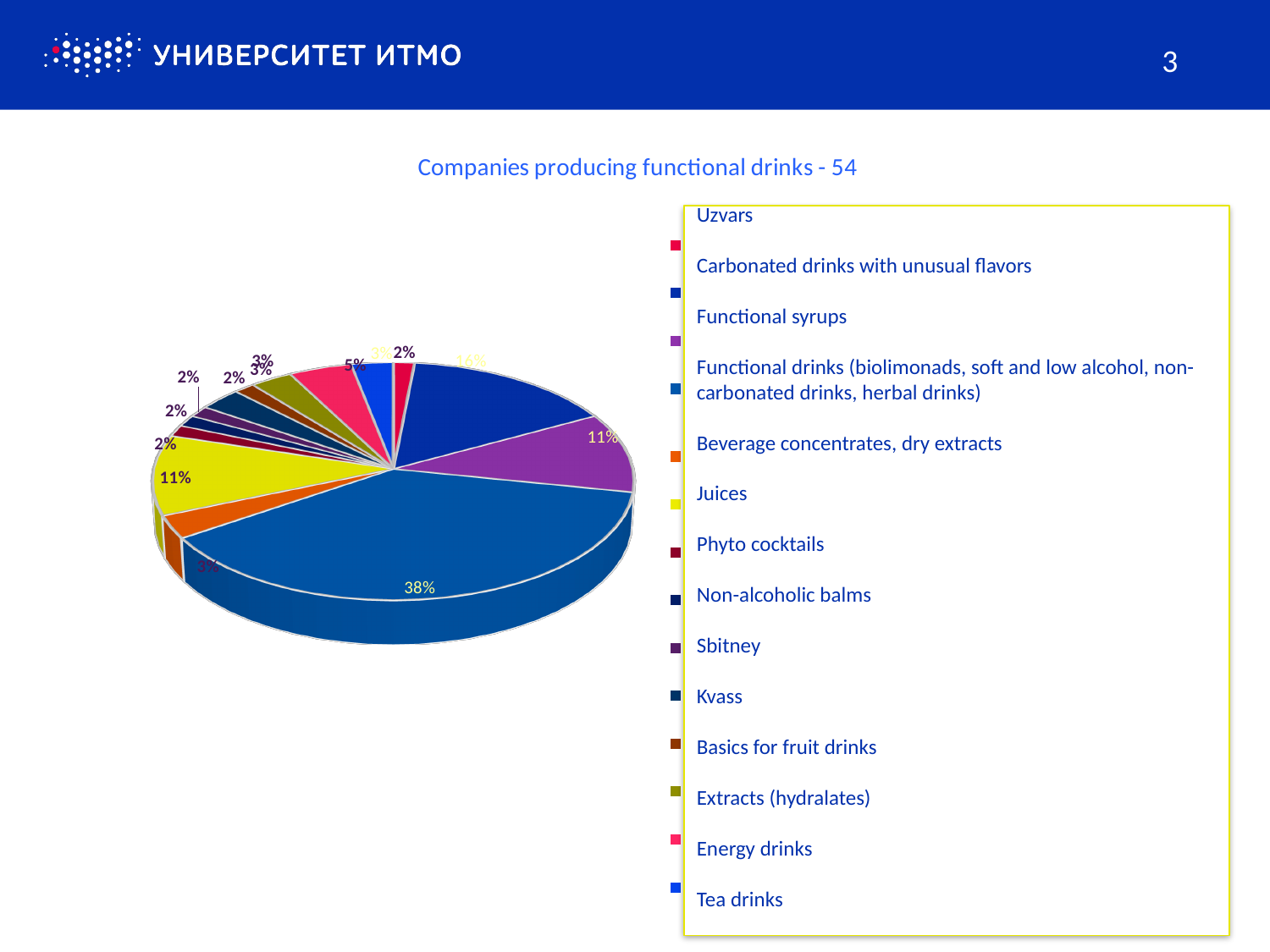
What share of the pie is labelled for the yellow slice (Juices)? 11% Which is larger: the 38% slice or the 16% slice? The 38% slice How many slices in the pie chart are labelled 2%? 5 What type of chart is shown on the slide? Pie chart What is the title of the chart? Companies producing functional drinks - 54 What share of the pie is labelled for the pink slice (Energy drinks)? 5% What is the share of the largest slice in the pie chart? 38% What is the difference in percentage points between the largest slice (38%) and the 16% slice? 22 percentage points How many categories does the legend of the pie chart list? 14 What is the share of the smallest slices in the pie chart? 2% What share of the pie is labelled for the orange slice (Beverage concentrates, dry extracts)? 3% Which legend entry is listed first in the pie chart's legend? Uzvars